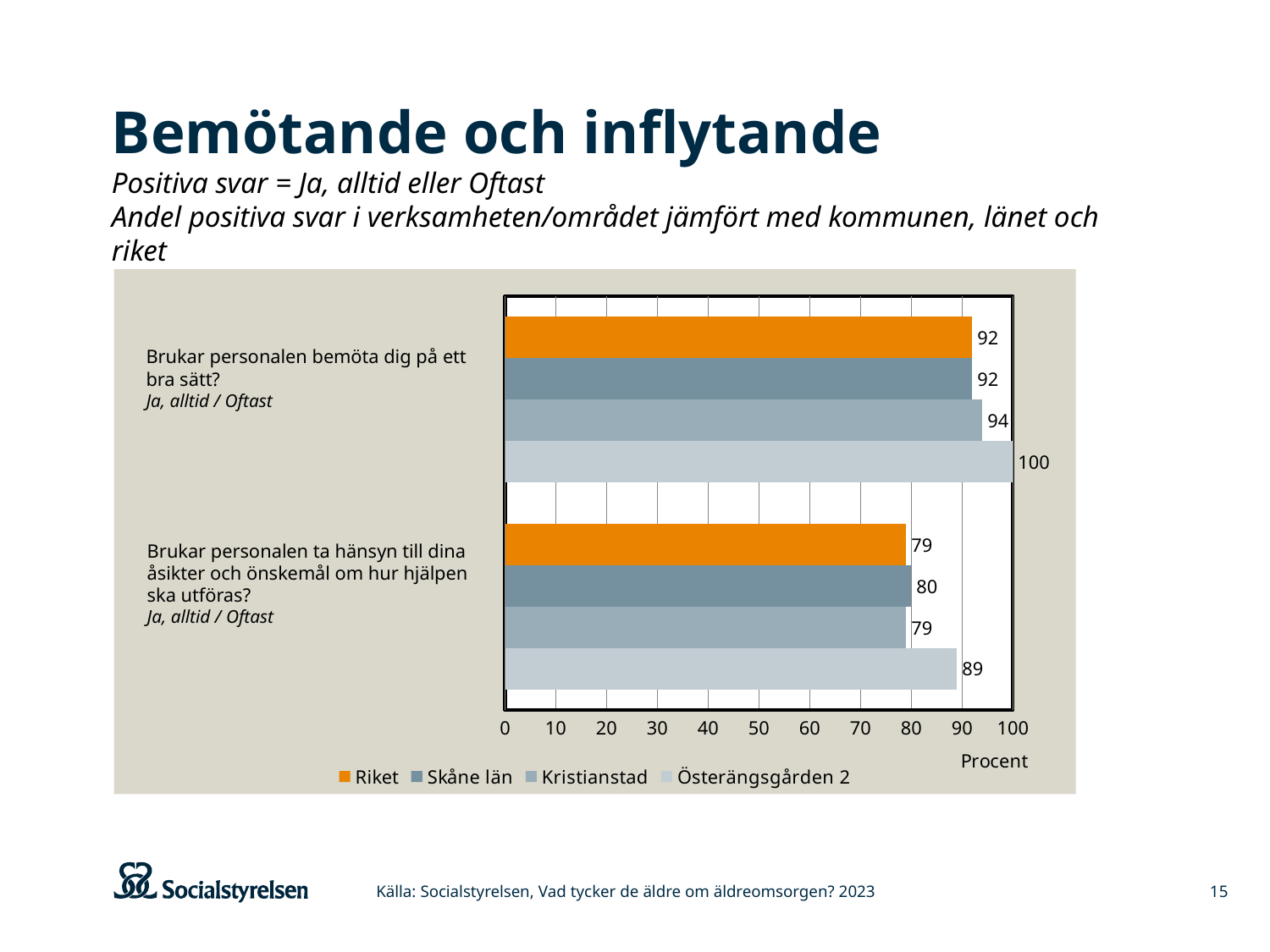
What is the difference between the Österängsgården 2 value and the Riket value on the question "Brukar personalen bemöta dig på ett bra sätt?"? 8 What value is shown for Österängsgården 2 on the question "Brukar personalen bemöta dig på ett bra sätt?"? 100 What is the difference between the Österängsgården 2 value and the Kristianstad value on the question "Brukar personalen ta hänsyn till dina åsikter och önskemål om hur hjälpen ska utföras?"? 10 Which is larger on the question "Brukar personalen bemöta dig på ett bra sätt?": the value for Kristianstad or the value for Riket? Kristianstad What kind of chart is shown on the slide? Bar chart What value is shown for Kristianstad on the question "Brukar personalen bemöta dig på ett bra sätt?"? 94 What value is shown for Skåne län on the question "Brukar personalen ta hänsyn till dina åsikter och önskemål om hur hjälpen ska utföras?"? 80 What value is shown for Riket on the question "Brukar personalen ta hänsyn till dina åsikter och önskemål om hur hjälpen ska utföras?"? 79 Which series has the highest value on the question "Brukar personalen ta hänsyn till dina åsikter och önskemål om hur hjälpen ska utföras?"? Österängsgården 2 What unit label is shown on the horizontal axis of the chart? Procent How many questions (categories) are shown on the chart? 2 How many series does the legend list? 4